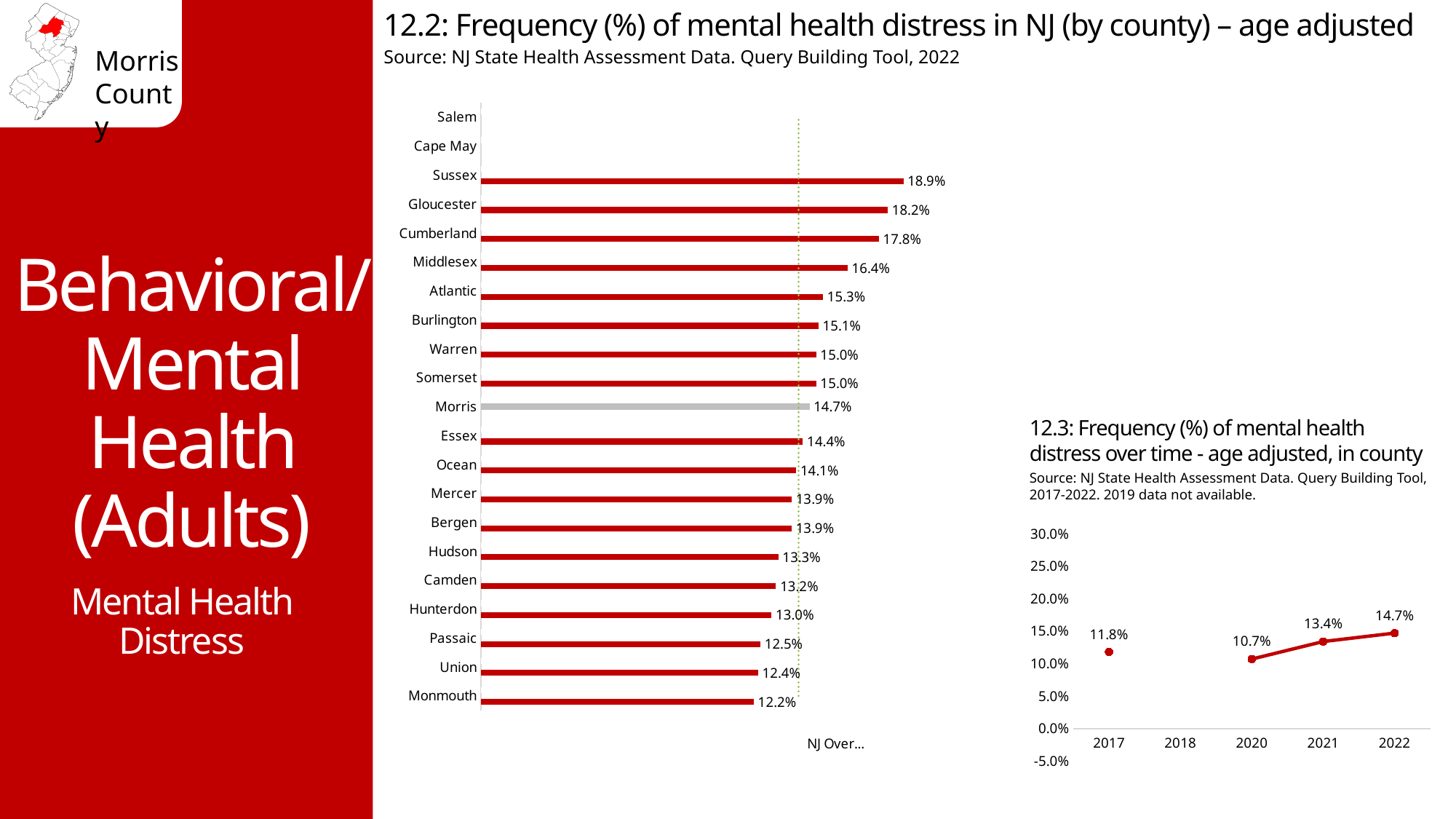
In chart 12.2, which county has the highest frequency of mental health distress? Sussex In chart 12.2, which county with a plotted bar has the lowest frequency of mental health distress? Monmouth In chart 12.2, which two counties have no bar plotted? Salem and Cape May In chart 12.2, what is the frequency of mental health distress for Morris County? 14.7% In chart 12.3, what is the difference between the 2022 and 2021 values? 1.3% In chart 12.2, what is the value for Gloucester? 18.2% In chart 12.3, which year has the highest value? 2022 In chart 12.2, which county has a higher value, Middlesex or Atlantic? Middlesex In chart 12.2, what is the difference between the values for Sussex and Morris? 4.2% In chart 12.3, how many data points are plotted? 4 What type of chart is chart 12.2? Bar chart In chart 12.3, what was the frequency of mental health distress in 2020? 10.7%